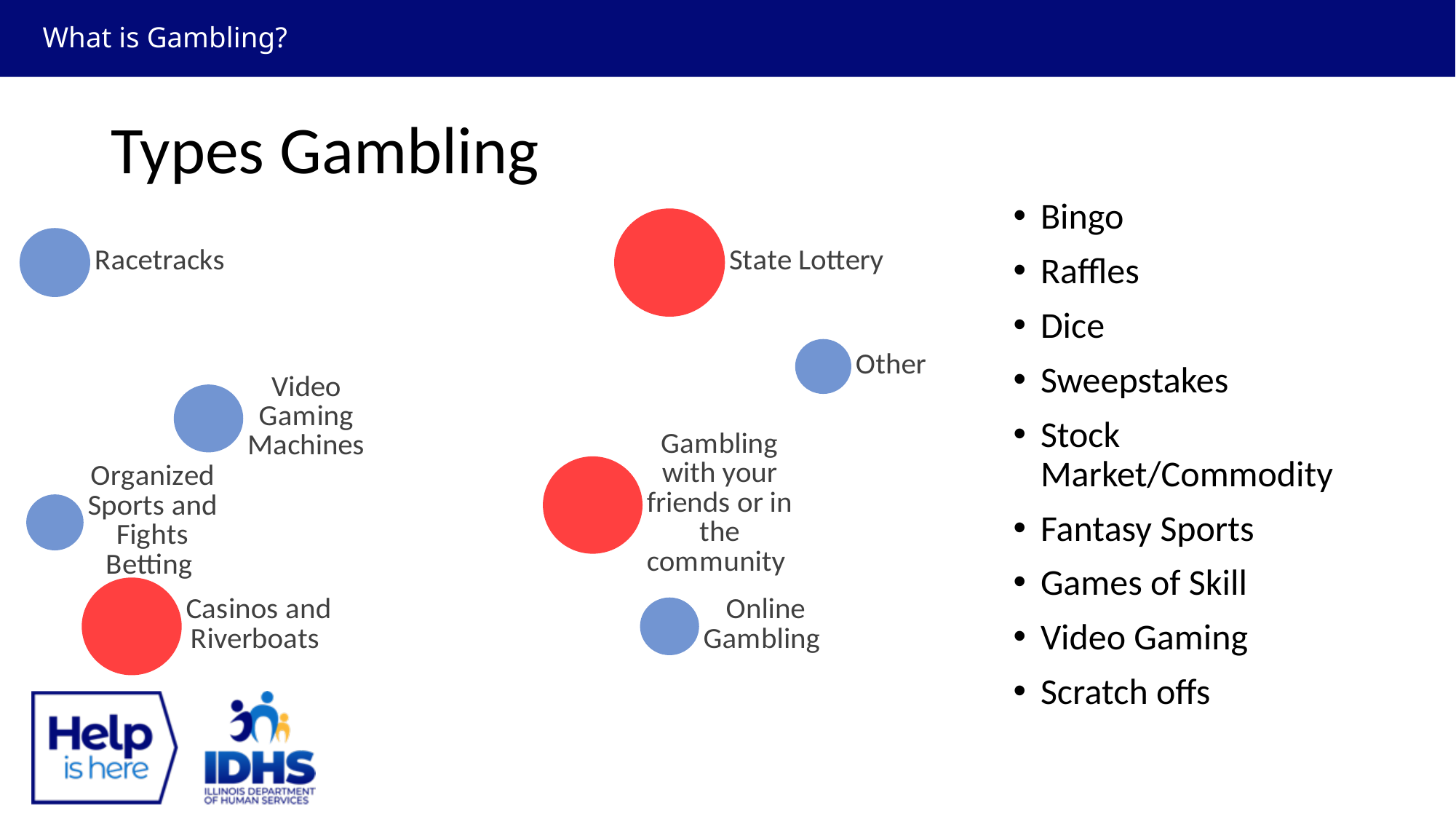
What colour is the bubble for Video Gaming Machines? blue Which is larger on the chart, the bubble for Other or the bubble for Casinos and Riverboats? Casinos and Riverboats What is the title above the chart? Types Gambling How many labelled bubbles are plotted on the chart? 8 Which is larger on the chart, the bubble for Online Gambling or the bubble for Gambling with your friends or in the community? Gambling with your friends or in the community Which is larger on the chart, the bubble for Racetracks or the bubble for State Lottery? State Lottery How many bubbles on the chart are blue? 5 How many bubbles on the chart are red? 3 What kind of chart is shown on the slide? bubble chart